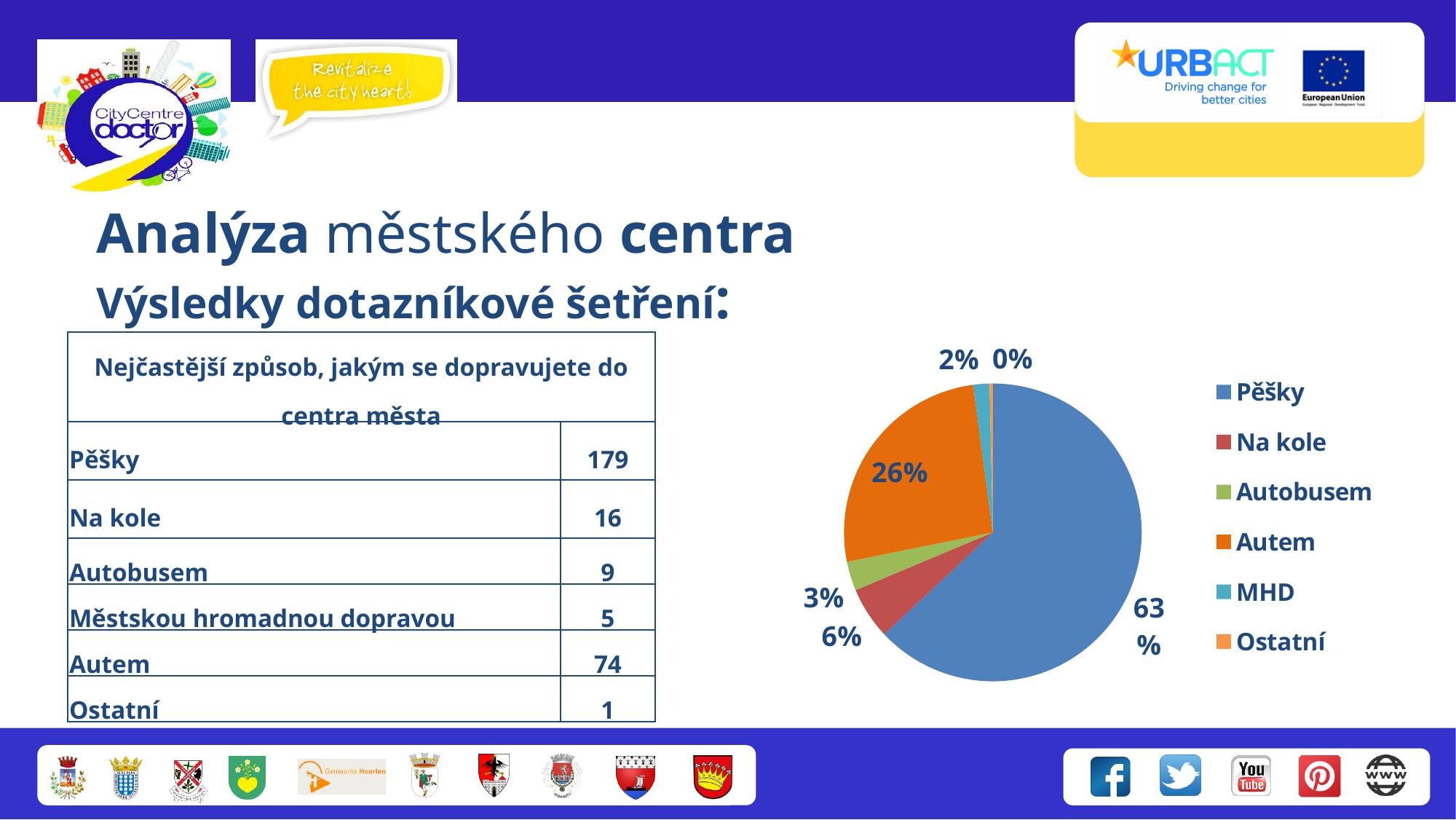
What share of the pie does the Ostatní slice have? 0% What share of the pie does the MHD slice have? 2% What share of the pie does the Na kole slice have? 6% What kind of chart is shown on the slide? pie chart Which category has the smallest slice of the pie chart? Ostatní Which slice is larger in the pie chart, Autem or Na kole? Autem Which category has the largest slice of the pie chart? Pěšky How many entries does the pie chart's legend list? 6 What is the difference in percentage points between the Pěšky slice and the Autem slice? 37